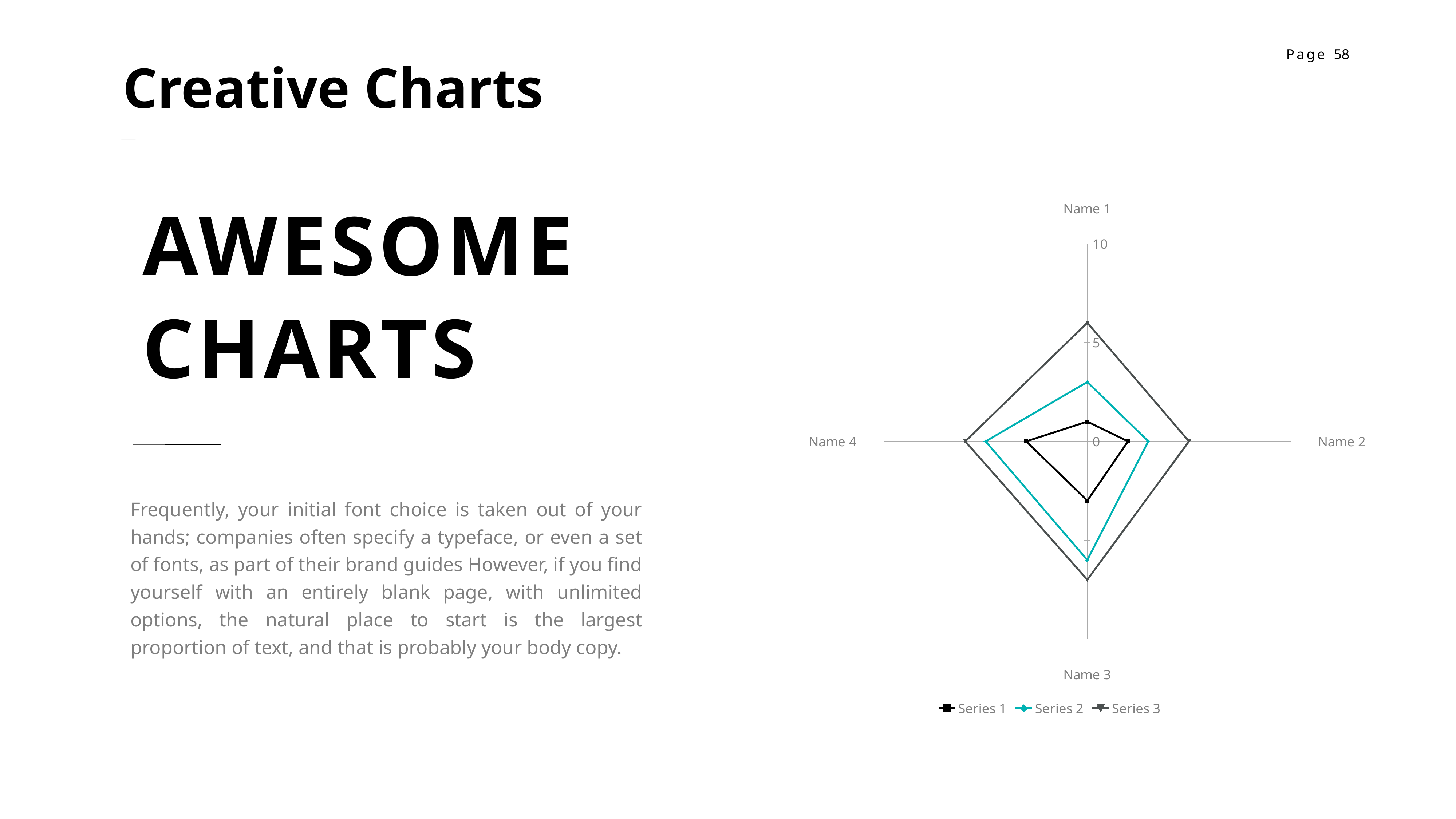
How many series does the legend list? 3 What is the maximum value shown on the radar chart's axis scale? 10 Is the value of Series 2 for Name 1 greater or less than 5? less For Name 1, which is larger: Series 2 or Series 1? Series 2 Is the value of Series 1 for Name 3 greater or less than 5? less What kind of chart is shown on the slide? Radar chart For which category does Series 3 have its highest value? Name 3 Is the value of Series 3 for Name 3 greater or less than 5? greater How many categories (axes) does the radar chart have? 4 For Name 3, which is larger: Series 3 or Series 1? Series 3 For which category does Series 1 have its lowest value? Name 1